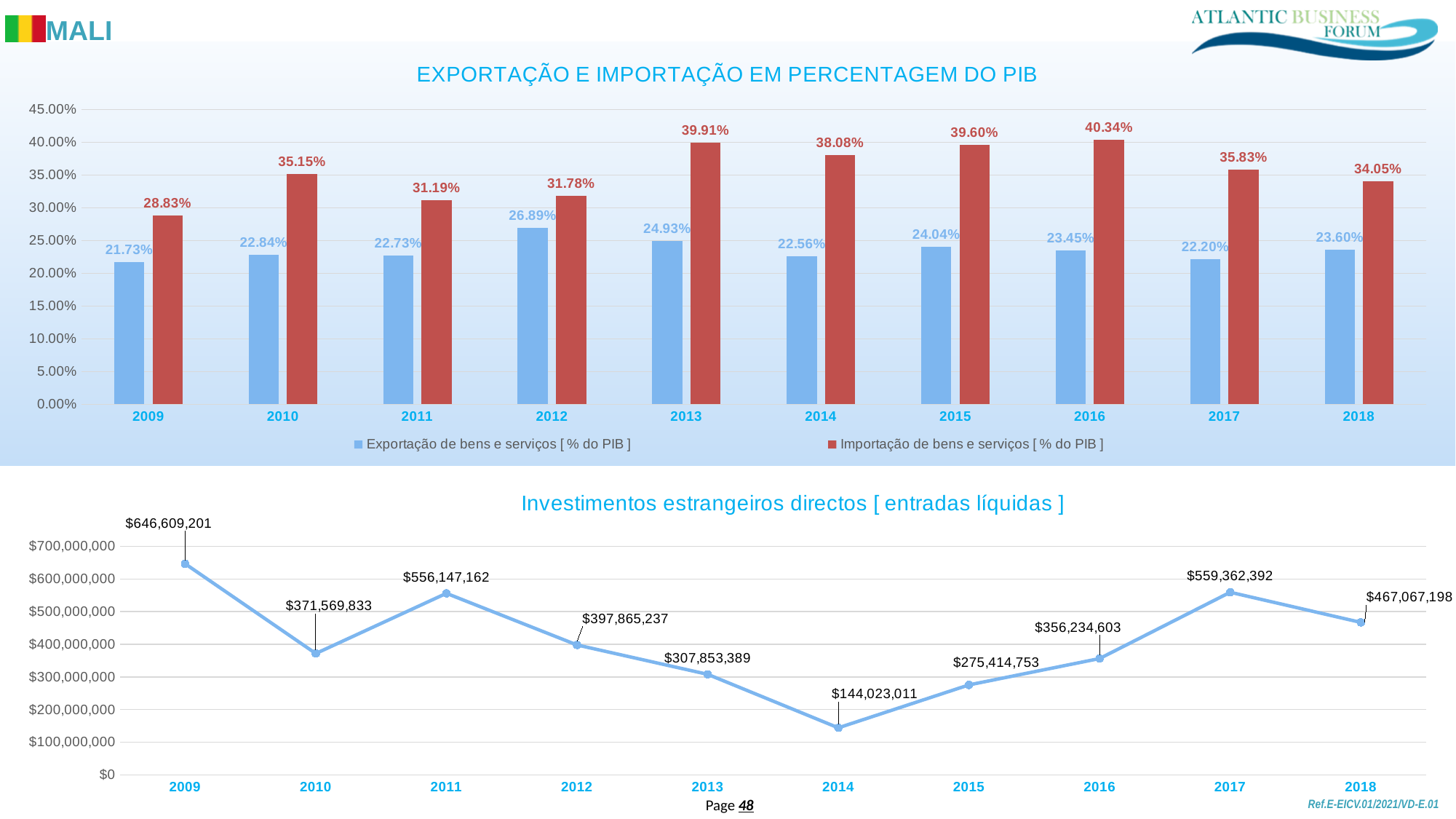
In the chart 'EXPORTAÇÃO E IMPORTAÇÃO EM PERCENTAGEM DO PIB', how many series does the legend list? 2 In the chart 'EXPORTAÇÃO E IMPORTAÇÃO EM PERCENTAGEM DO PIB', which year has the lowest Exportação de bens e serviços value? 2009 What kind of chart is 'EXPORTAÇÃO E IMPORTAÇÃO EM PERCENTAGEM DO PIB'? Bar chart In the chart 'Investimentos estrangeiros directos [ entradas líquidas ]', what is the value for 2014? $144,023,011 In the chart 'EXPORTAÇÃO E IMPORTAÇÃO EM PERCENTAGEM DO PIB', what is the value of Exportação de bens e serviços for 2012? 26.89% In the chart 'EXPORTAÇÃO E IMPORTAÇÃO EM PERCENTAGEM DO PIB', what is the difference between Importação and Exportação in 2013? 14.98% What kind of chart is 'Investimentos estrangeiros directos [ entradas líquidas ]'? Line chart In the chart 'Investimentos estrangeiros directos [ entradas líquidas ]', which year has the highest value? 2009 In the chart 'EXPORTAÇÃO E IMPORTAÇÃO EM PERCENTAGEM DO PIB', which year has the highest Importação de bens e serviços value? 2016 In the chart 'Investimentos estrangeiros directos [ entradas líquidas ]', how many years are plotted? 10 In the chart 'Investimentos estrangeiros directos [ entradas líquidas ]', is the value for 2017 larger or smaller than the value for 2018? Larger In the chart 'EXPORTAÇÃO E IMPORTAÇÃO EM PERCENTAGEM DO PIB', what is the value of Importação de bens e serviços for 2014? 38.08%